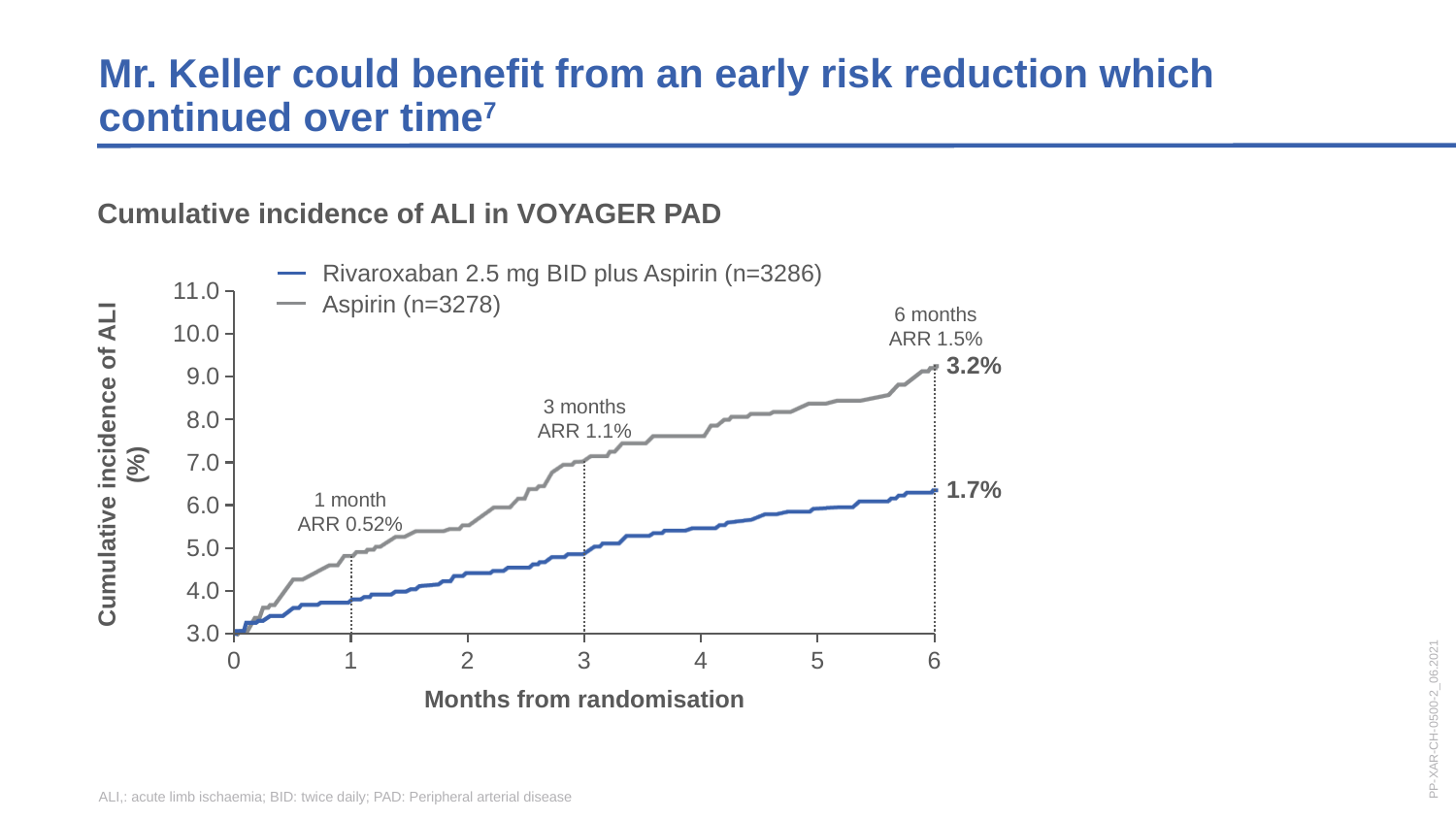
What is the title of the chart? Cumulative incidence of ALI in VOYAGER PAD What is the title of the x axis? Months from randomisation Which group has the higher cumulative incidence of ALI at 6 months? Aspirin (n=3278) Do the cumulative incidence curves rise or fall as months from randomisation increase? Rise What cumulative incidence of ALI is labelled for the Rivaroxaban 2.5 mg BID plus Aspirin group at 6 months? 1.7% What ARR is annotated at 3 months? 1.1% What ARR is annotated at 6 months? 1.5% What ARR is annotated at 1 month? 0.52% What cumulative incidence of ALI is labelled for the Aspirin group at 6 months? 3.2% What kind of chart is shown on the slide? Line chart What is the difference between the labelled 6-month values for Aspirin (3.2%) and Rivaroxaban plus Aspirin (1.7%)? 1.5% How many series does the legend list? 2